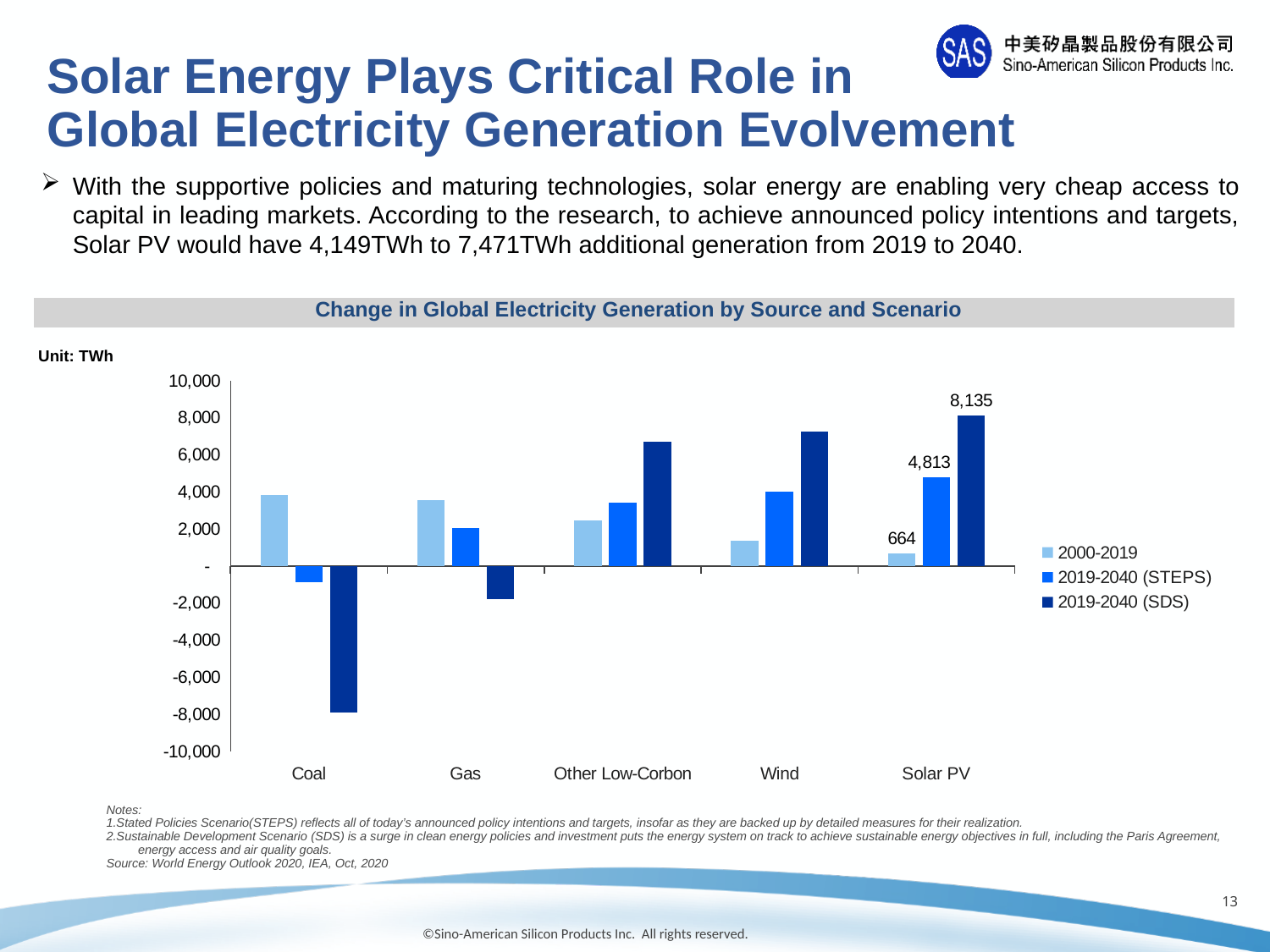
Which source has the highest value in the 2019-2040 (SDS) series? Solar PV Is the value for Coal in the 2019-2040 (SDS) series greater or less than -6,000? less Is the value for Wind in the 2019-2040 (SDS) series greater or less than 6,000? greater Which source has the lowest value in the 2019-2040 (SDS) series? Coal What is the value for Solar PV in the 2019-2040 (SDS) series? 8,135 What is the difference between the Solar PV values for 2019-2040 (STEPS) and 2000-2019? 4,149 What is the value for Solar PV in the 2000-2019 series? 664 For Solar PV, which is larger: the 2019-2040 (STEPS) value or the 2019-2040 (SDS) value? 2019-2040 (SDS) How many sources are shown on the x axis of the chart? 5 How many series does the chart's legend list? 3 What is the value for Solar PV in the 2019-2040 (STEPS) series? 4,813 What is the difference between the Solar PV values for 2019-2040 (SDS) and 2019-2040 (STEPS)? 3,322